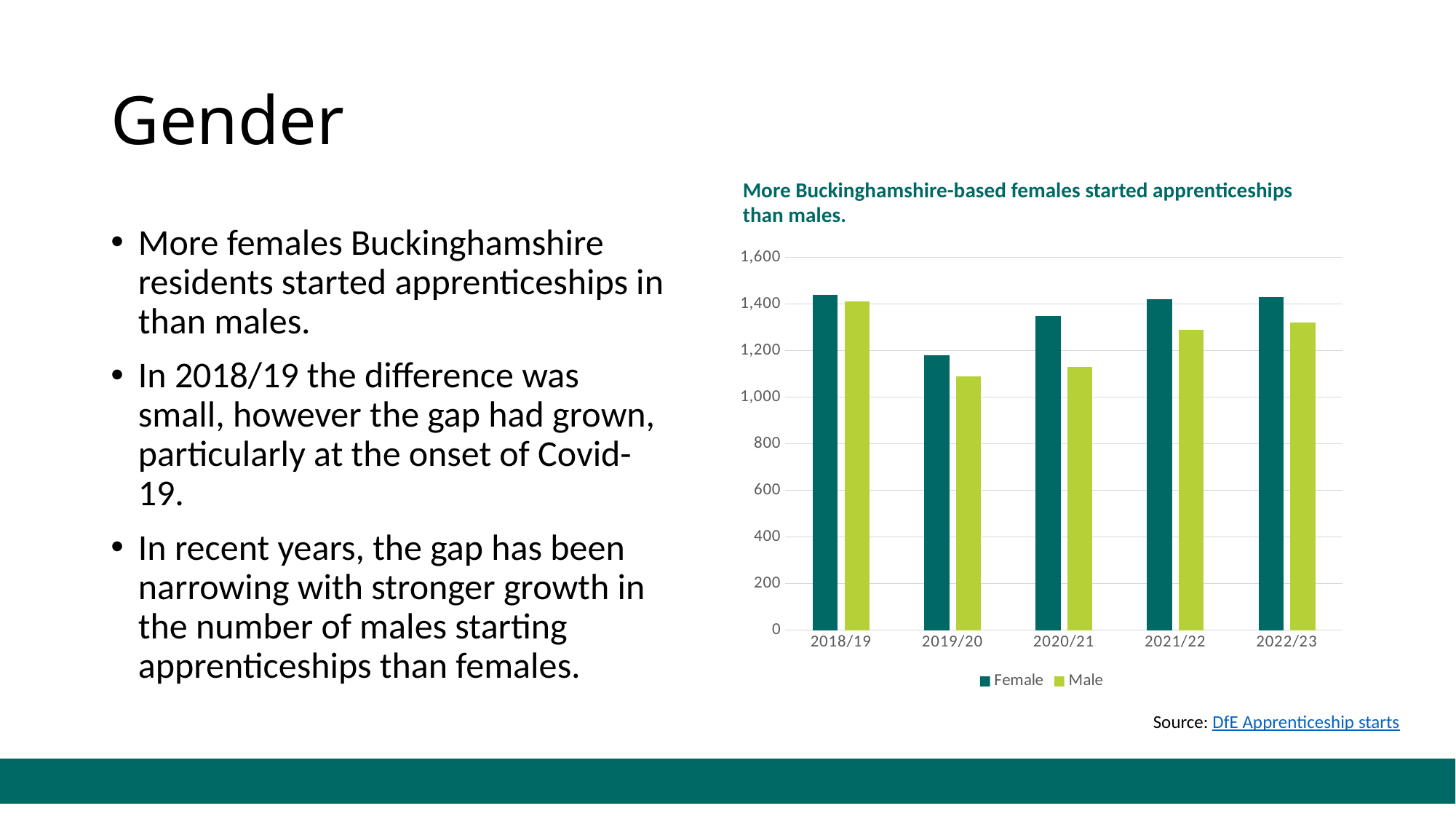
Is the value for Female in 2018/19 greater or less than 1,400? greater Do the Male values rise or fall from 2019/20 to 2022/23? rise Is the value for Male in 2019/20 greater or less than 1,000? greater What is the title of the chart? More Buckinghamshire-based females started apprenticeships than males. Which year has the lowest value for Female? 2019/20 What kind of chart is shown on the slide? bar chart In 2020/21, which is larger, Female or Male? Female Is the value for Male in 2021/22 greater or less than 1,400? less How many academic years are shown on the x axis? 5 Which year has the highest value for Male? 2018/19 How many series does the legend list? 2